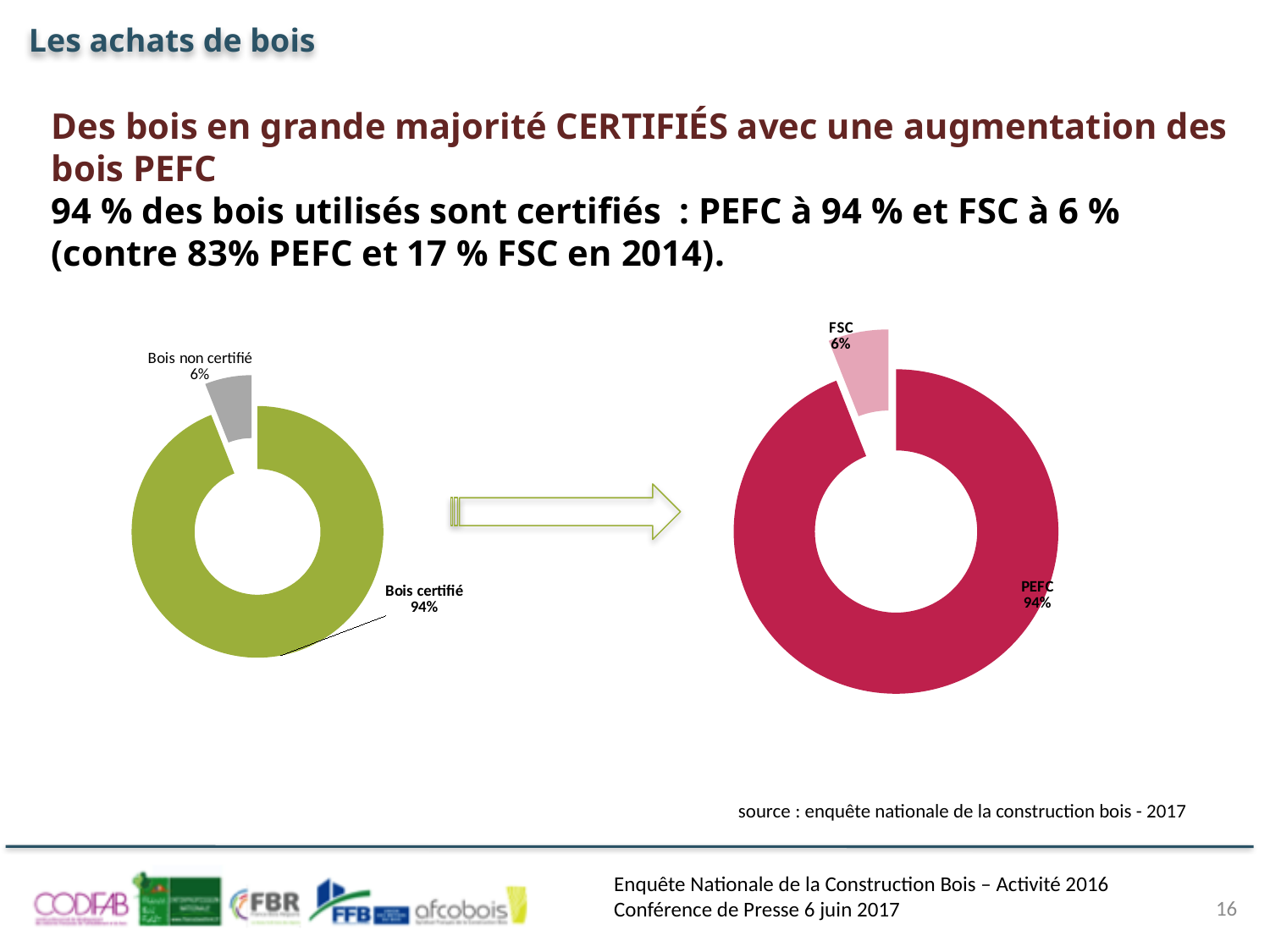
In the left chart, what share is labelled for Bois certifié? 94% In the right chart, what share is labelled for FSC? 6% In the left chart, which category has the largest share? Bois certifié In the right chart, what is the difference in percentage points between PEFC and FSC? 88 In the left chart, what share is labelled for Bois non certifié? 6% In the left chart, which is larger: Bois certifié or Bois non certifié? Bois certifié What kind of chart is the left chart? Doughnut (pie) chart In the right chart, which category has the smallest share? FSC How many slices does the right chart have? 2 In the right chart, what share is labelled for PEFC? 94% In the right chart, what colour is the FSC slice? Light pink In the left chart, what colour is the Bois certifié slice? Green